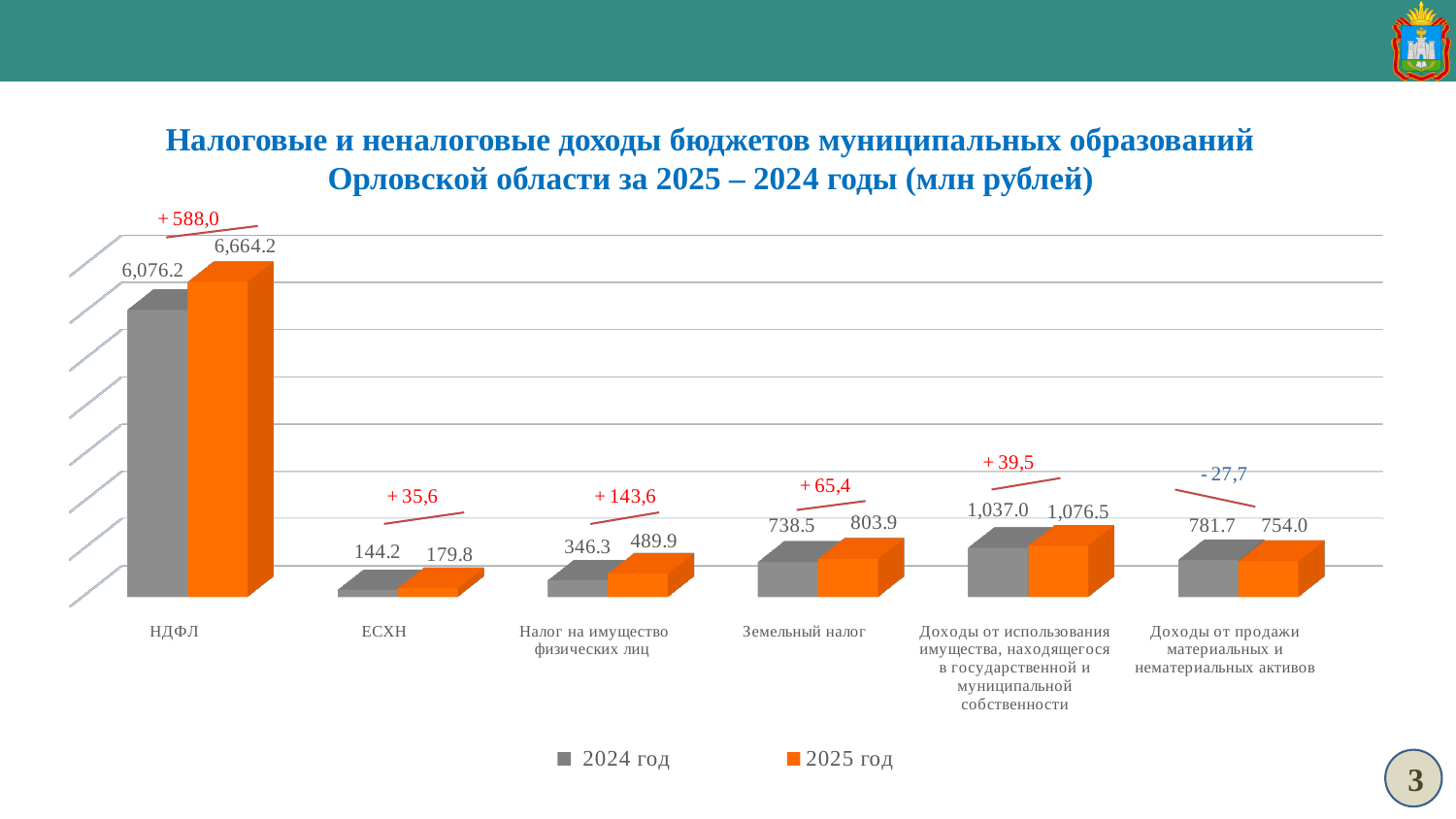
What is the change shown for Доходы от продажи материальных и нематериальных активов between 2024 год and 2025 год? - 27,7 Which is larger for Доходы от продажи материальных и нематериальных активов: the 2024 год value or the 2025 год value? 2024 год How many categories are shown on the x axis? 6 What is the value for ЕСХН in 2025 год? 179.8 What is the change shown for НДФЛ between 2024 год and 2025 год? + 588,0 How many series does the legend list? 2 What kind of chart is shown on the slide? Bar chart Which category has the highest value in 2025 год? НДФЛ What is the value for НДФЛ in 2025 год? 6,664.2 What is the value for Налог на имущество физических лиц in 2024 год? 346.3 What is the value for Земельный налог in 2024 год? 738.5 Which category has the lowest value in 2024 год? ЕСХН